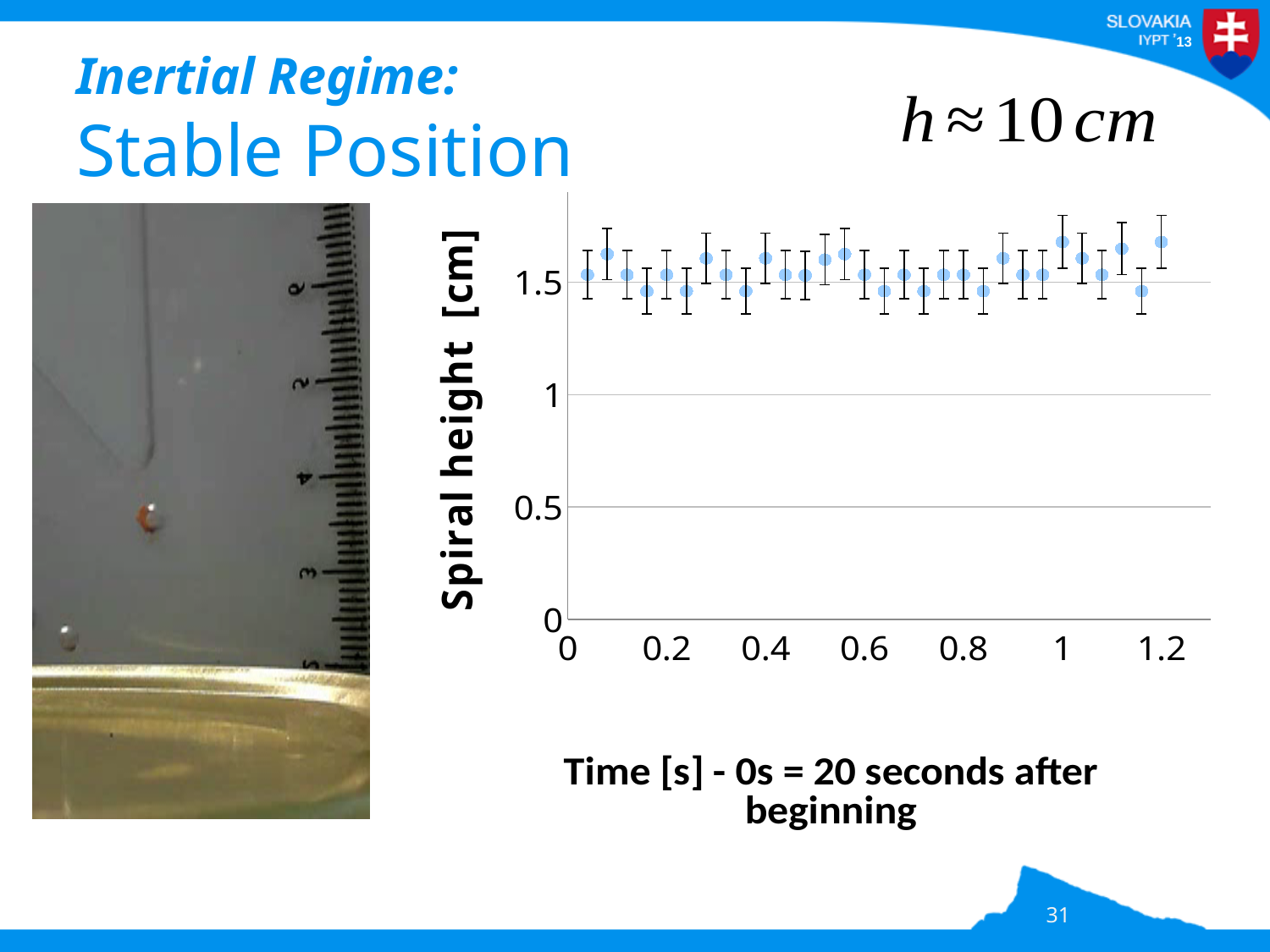
Is the spiral height at time 0.2 s greater or less than 1 cm? greater Is the spiral height at time 1 s greater or less than 1 cm? greater What is the label of the y axis of the chart? Spiral height [cm] What kind of chart is shown on the slide? scatter chart Is the spiral height at time 0.4 s greater or less than 0.5 cm? greater Do the spiral height values rise, fall, or stay roughly constant as time increases from 0 to 1.2 s? stay roughly constant What is the label of the x axis of the chart? Time [s] - 0s = 20 seconds after beginning